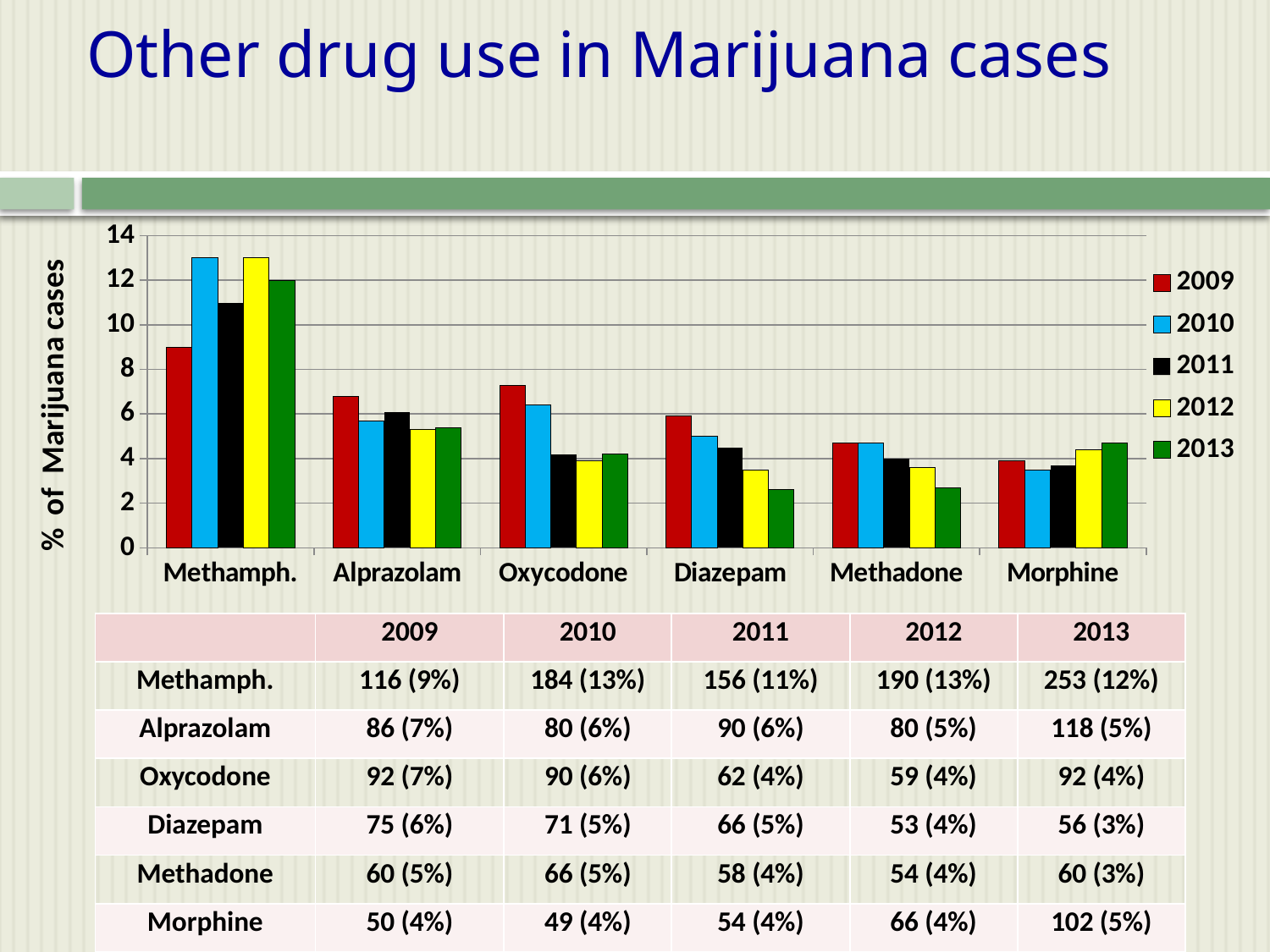
Which is larger for Alprazolam: the 2009 bar or the 2013 bar? 2009 Is the 2010 value for Methamph. greater or less than 12? greater What kind of chart is shown on the slide? bar chart Which drug category has the lowest bar for 2009? Morphine What is the title of the y axis of the chart? % of Marijuana cases Do the bars for Diazepam rise or fall from 2009 to 2013? fall Which drug category has the highest bar for 2009? Methamph. Is the 2009 value for Oxycodone greater or less than 6? greater How many series does the chart legend list? 5 How many drug categories are shown on the x axis of the chart? 6 Is the 2013 value for Diazepam greater or less than 4? less Which is larger for Morphine: the 2010 bar or the 2013 bar? 2013